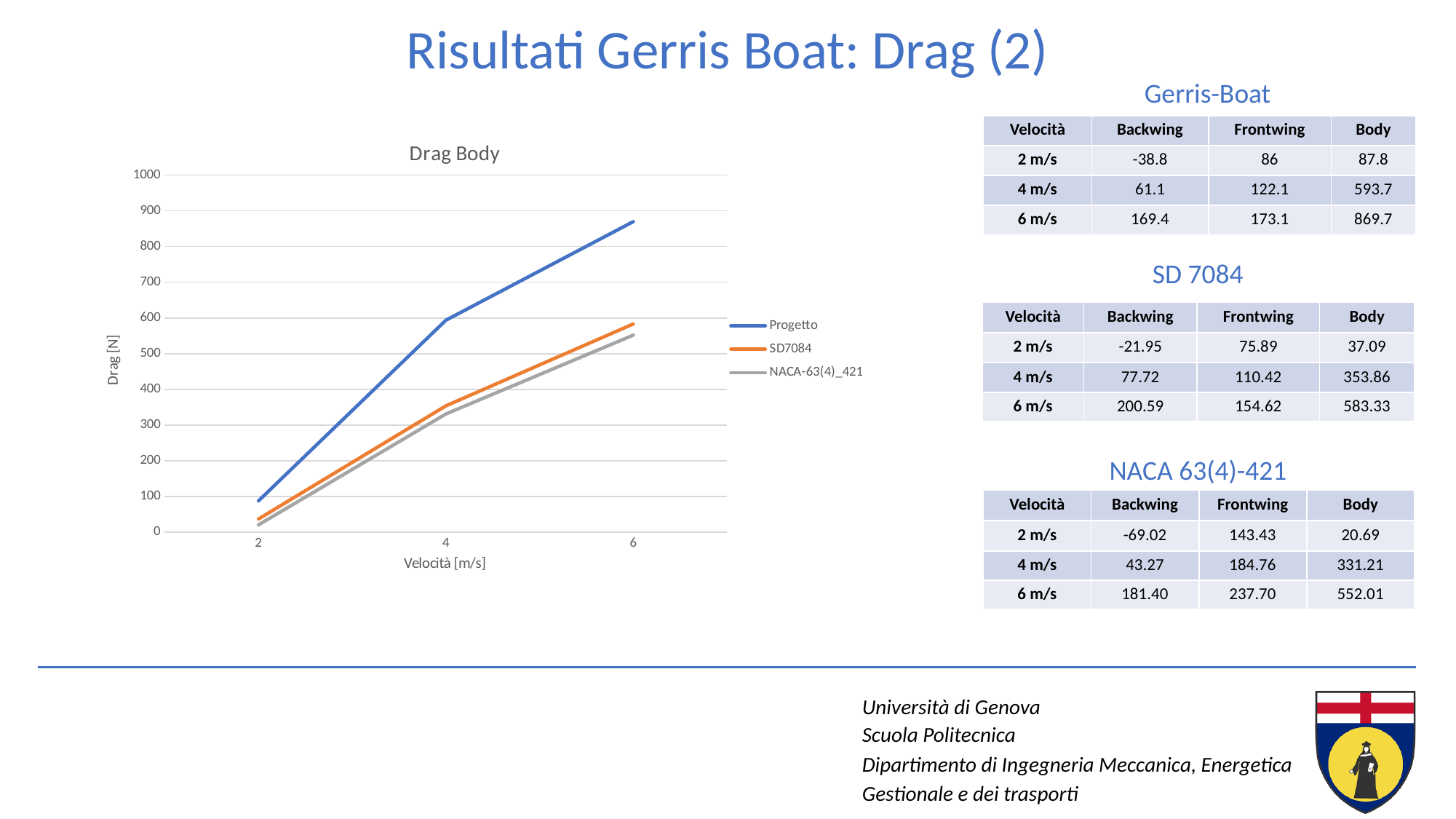
Which series has the highest drag at a velocity of 6 m/s? Progetto Is the drag for SD7084 at 4 m/s greater or less than 300? greater Does the drag for Progetto rise or fall as velocity increases from 2 to 6 m/s? rise How many velocity points are plotted along the x axis of the chart? 3 What is the title of the chart? Drag Body Is the drag for Progetto at 6 m/s greater or less than 800? greater How many series does the chart legend list? 3 Is the drag for NACA-63(4)_421 at 2 m/s greater or less than 100? less At 6 m/s, which is larger: the drag for Progetto or the drag for SD7084? Progetto Which series has the lowest drag at a velocity of 4 m/s? NACA-63(4)_421 What kind of chart is shown on the slide? line chart